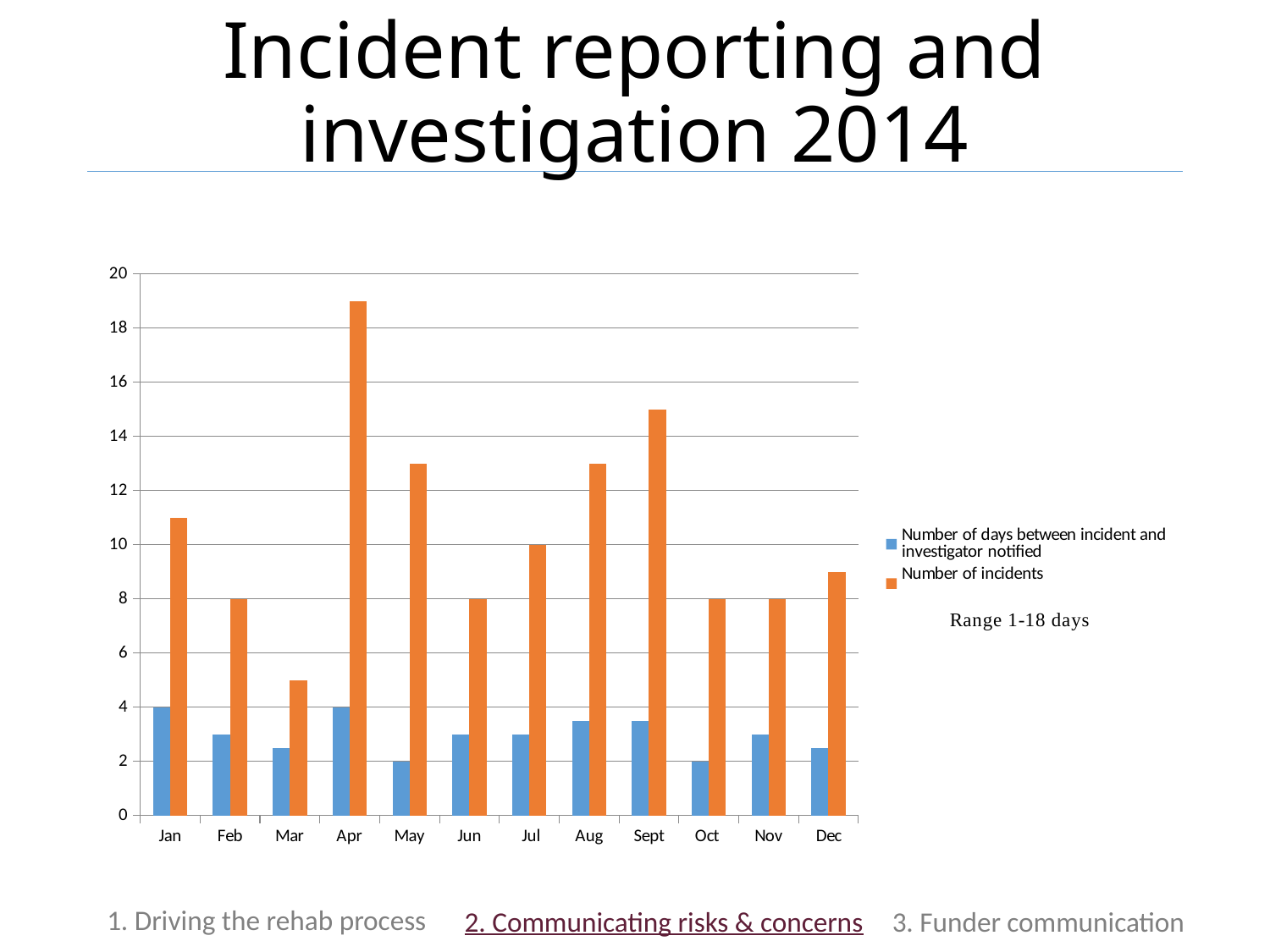
Which month has the highest number of incidents? Apr What is the number of incidents in Feb? 8 What is the number of days between incident and investigator notified in Apr? 4 What kind of chart is shown on the slide? bar chart How many months are shown on the x axis? 12 Which month has the lowest number of incidents? Mar Is the number of incidents in Apr greater or less than 18? greater Is the number of incidents in Mar greater or less than 6? less Which month has more incidents, Sept or Aug? Sept What colour are the bars for the Number of incidents series? orange What is the number of incidents in Jul? 10 How many series does the legend list? 2